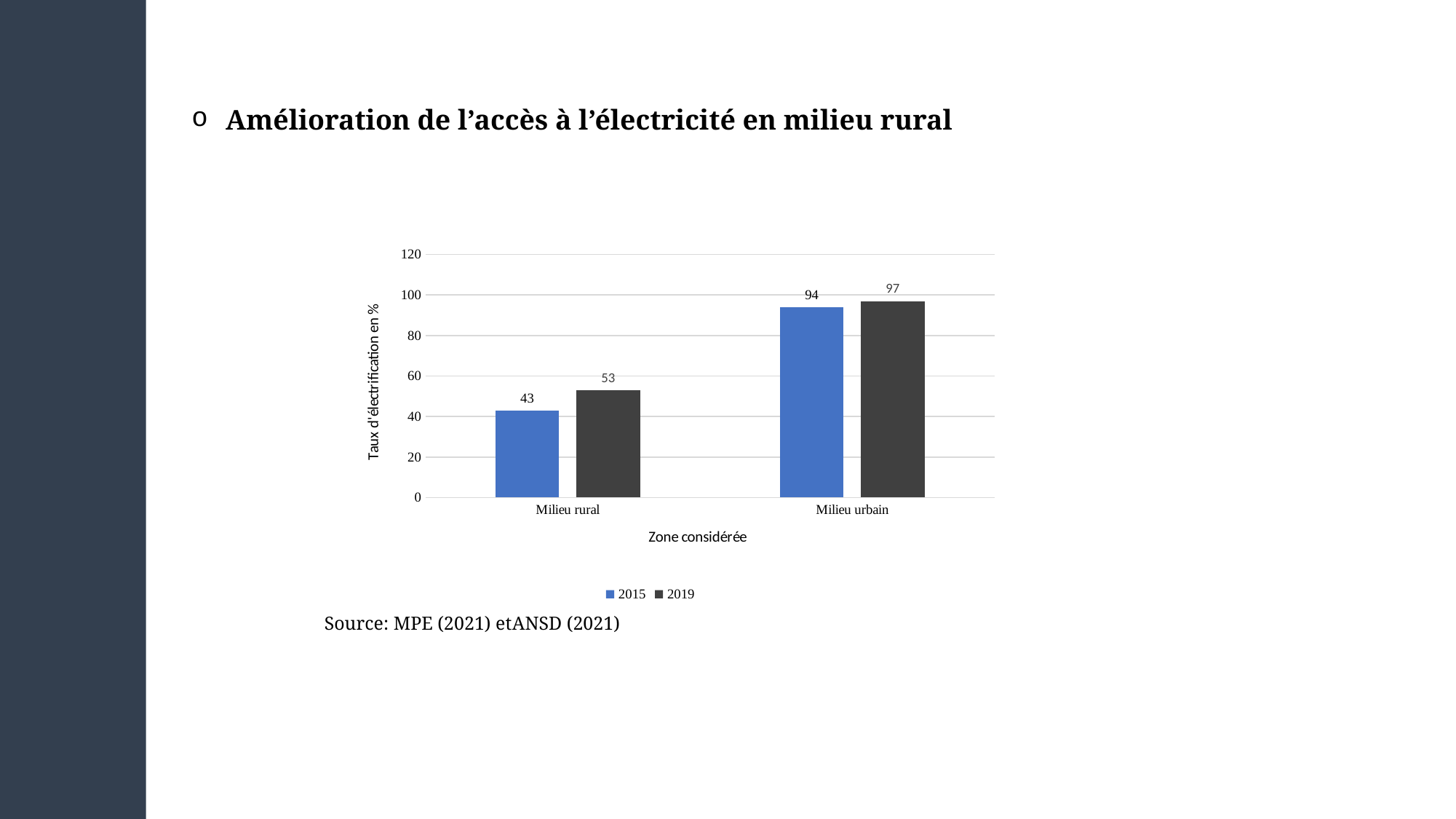
What is the electrification rate for Milieu rural in 2019? 53 Which is larger: the 2015 value for Milieu urbain or the 2019 value for Milieu rural? 2015 value for Milieu urbain What is the difference between the 2019 electrification rates of Milieu urbain and Milieu rural? 44 What kind of chart is shown on the slide? Bar chart Which zone has the lowest electrification rate in 2015? Milieu rural How many series does the legend list? 2 What is the electrification rate for Milieu urbain in 2019? 97 How many zones are shown on the x axis? 2 Which zone has the highest electrification rate in 2019? Milieu urbain What is the electrification rate for Milieu rural in 2015? 43 By how much did the electrification rate for Milieu rural increase from 2015 to 2019? 10 What is the electrification rate for Milieu urbain in 2015? 94